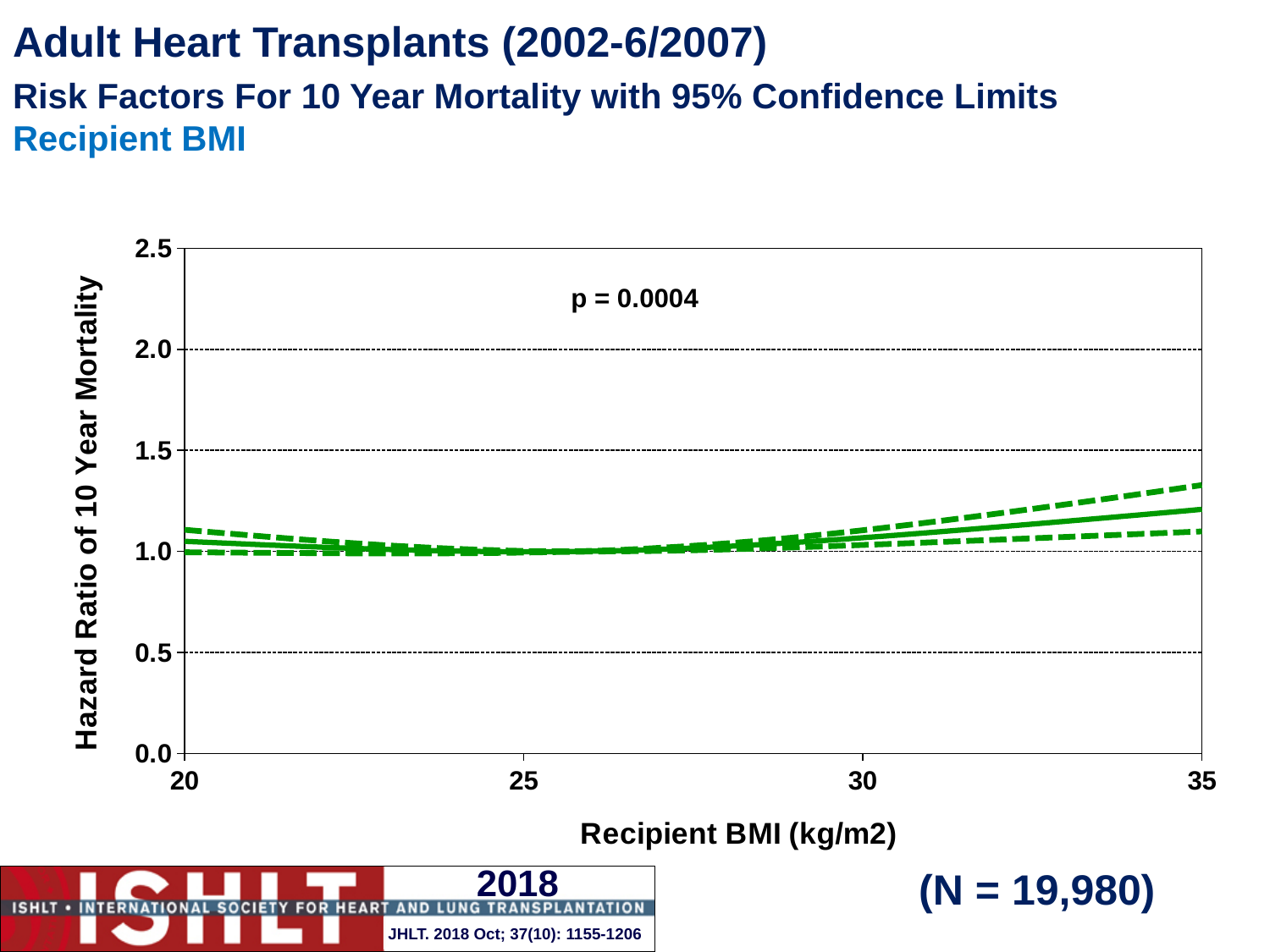
Is the hazard ratio at a recipient BMI of 35 higher or lower than at a recipient BMI of 25? higher Is the hazard ratio (solid line) at a recipient BMI of 20 greater or less than 0.5? greater What p-value is printed on the chart? p = 0.0004 Is the upper 95% confidence limit at a recipient BMI of 35 greater or less than 1.5? less How many lines are plotted on the chart (the estimate plus its confidence limits)? 3 What is the sample size (N) shown on the slide? N = 19,980 Is the hazard ratio (solid line) at a recipient BMI of 35 greater or less than 1.5? less What is the highest value shown on the y axis? 2.5 What kind of chart is shown on the slide? line chart Between a recipient BMI of 25 and 35, does the hazard ratio (solid line) rise or fall? rise